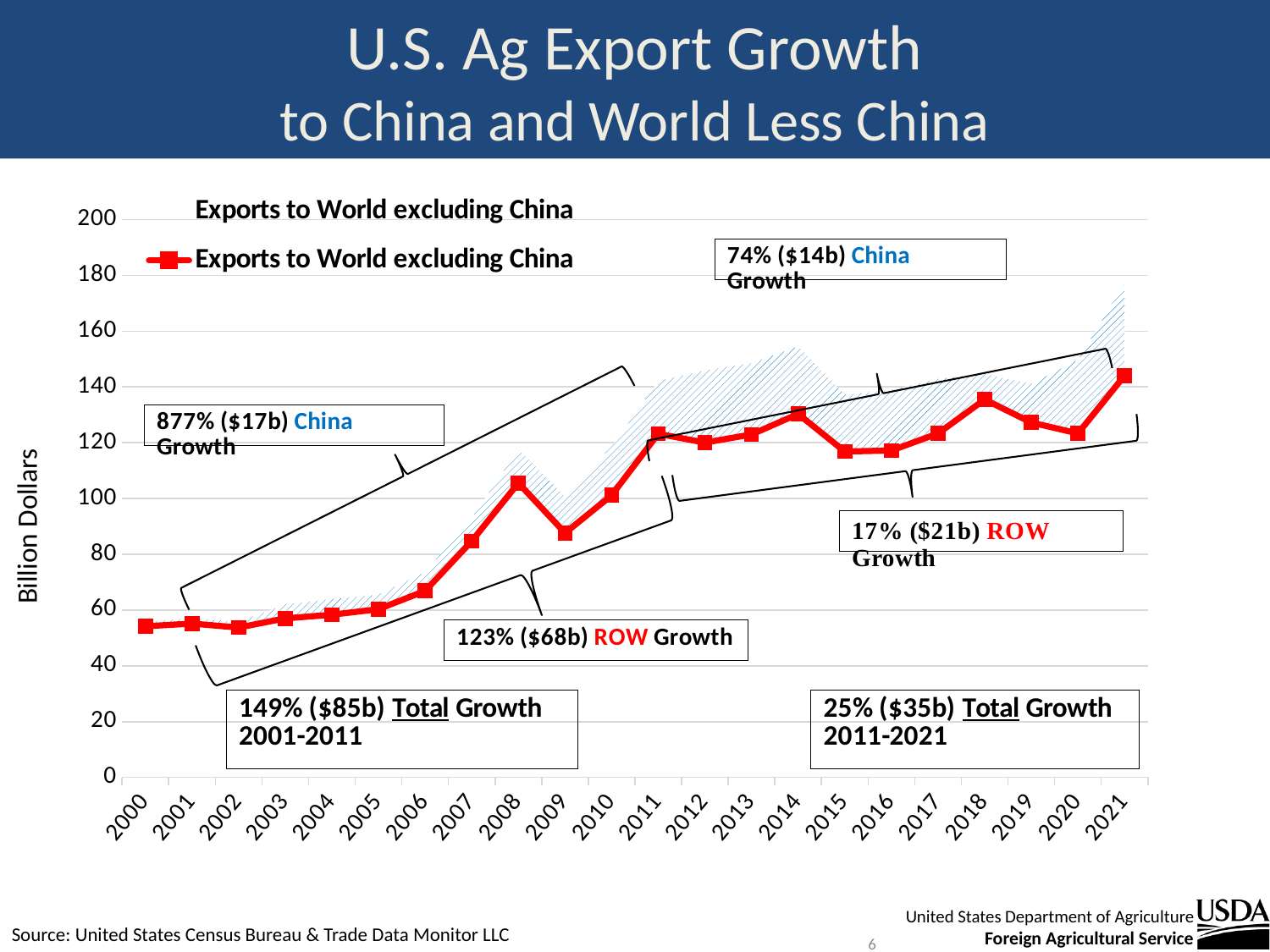
According to the annotation, what was the ROW Growth for 2011-2021? 17% ($21b) Is the value of the red line (Exports to World excluding China) in 2008 greater or less than 100? greater Is the value of the red line (Exports to World excluding China) in 2000 greater or less than 60? less Does the red line generally rise or fall from 2000 to 2021? Rise According to the annotation, what was the Total Growth from 2001-2011? 149% ($85b) How many entries does the legend list? 2 Which year has the larger value on the red line, 2008 or 2009? 2008 How many years are plotted along the x axis? 22 What kind of chart is shown on the slide? Combination line and area chart Is the value of the red line (Exports to World excluding China) in 2021 greater or less than 140? greater What is the label on the vertical axis? Billion Dollars In which year does the red line (Exports to World excluding China) reach its highest value? 2021